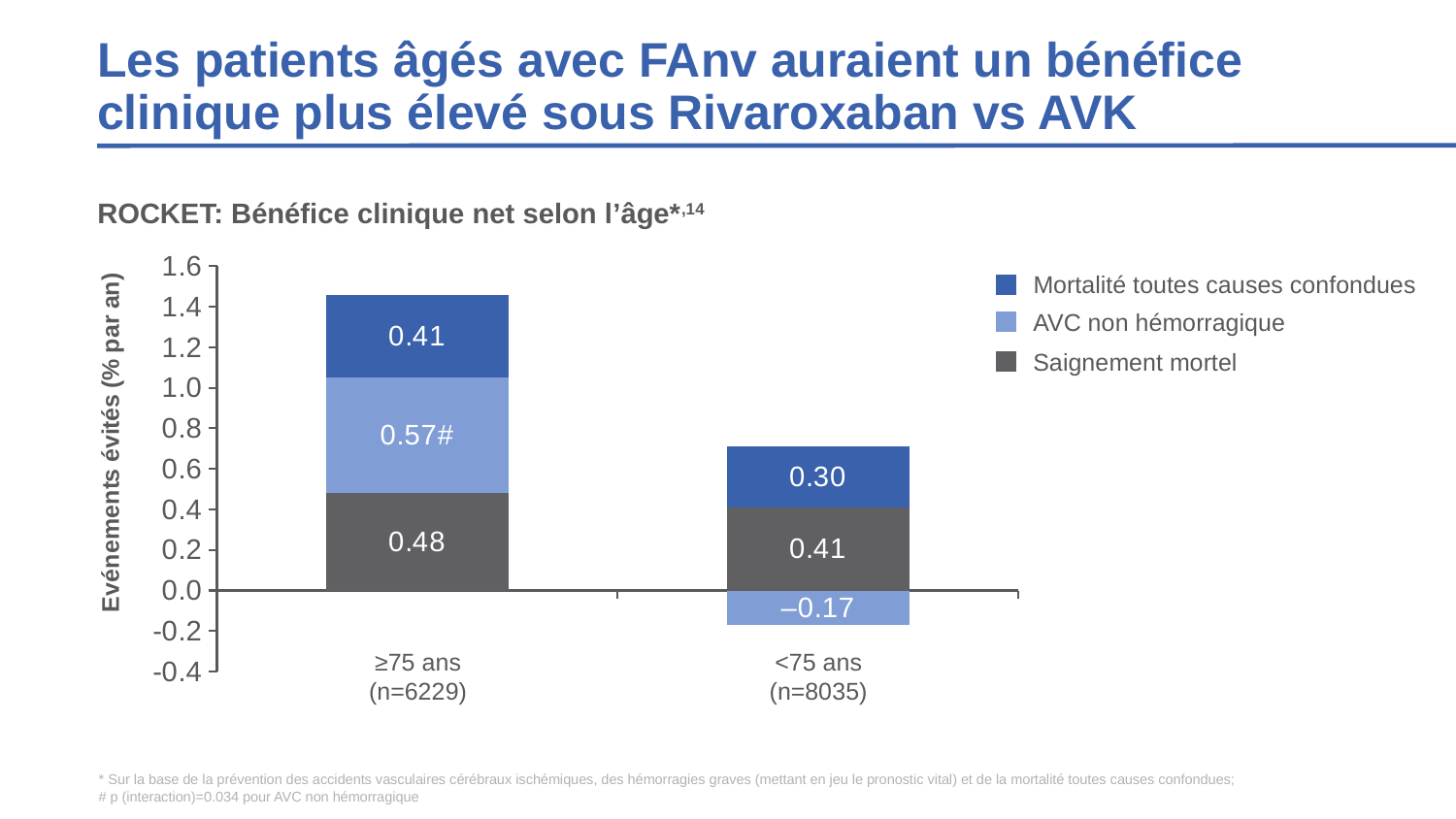
What is the value of the AVC non hémorragique segment for the <75 ans (n=8035) bar? –0.17 What is the title of the y axis? Evénements évités (% par an) What is the total of the three segments in the ≥75 ans (n=6229) stacked bar? 1.46 How many age categories are shown on the x axis? 2 What is the value of the Mortalité toutes causes confondues segment for the ≥75 ans (n=6229) bar? 0.41 What kind of chart is shown on the slide? Stacked bar chart What is the value of the AVC non hémorragique segment for the ≥75 ans (n=6229) bar? 0.57 What is the difference between the Saignement mortel values for ≥75 ans and <75 ans? 0.07 How many series does the legend list? 3 What is the difference between the Mortalité toutes causes confondues values for ≥75 ans and <75 ans? 0.11 What is the value of the Saignement mortel segment for the <75 ans (n=8035) bar? 0.41 Which age group has the larger Mortalité toutes causes confondues value, ≥75 ans or <75 ans? ≥75 ans